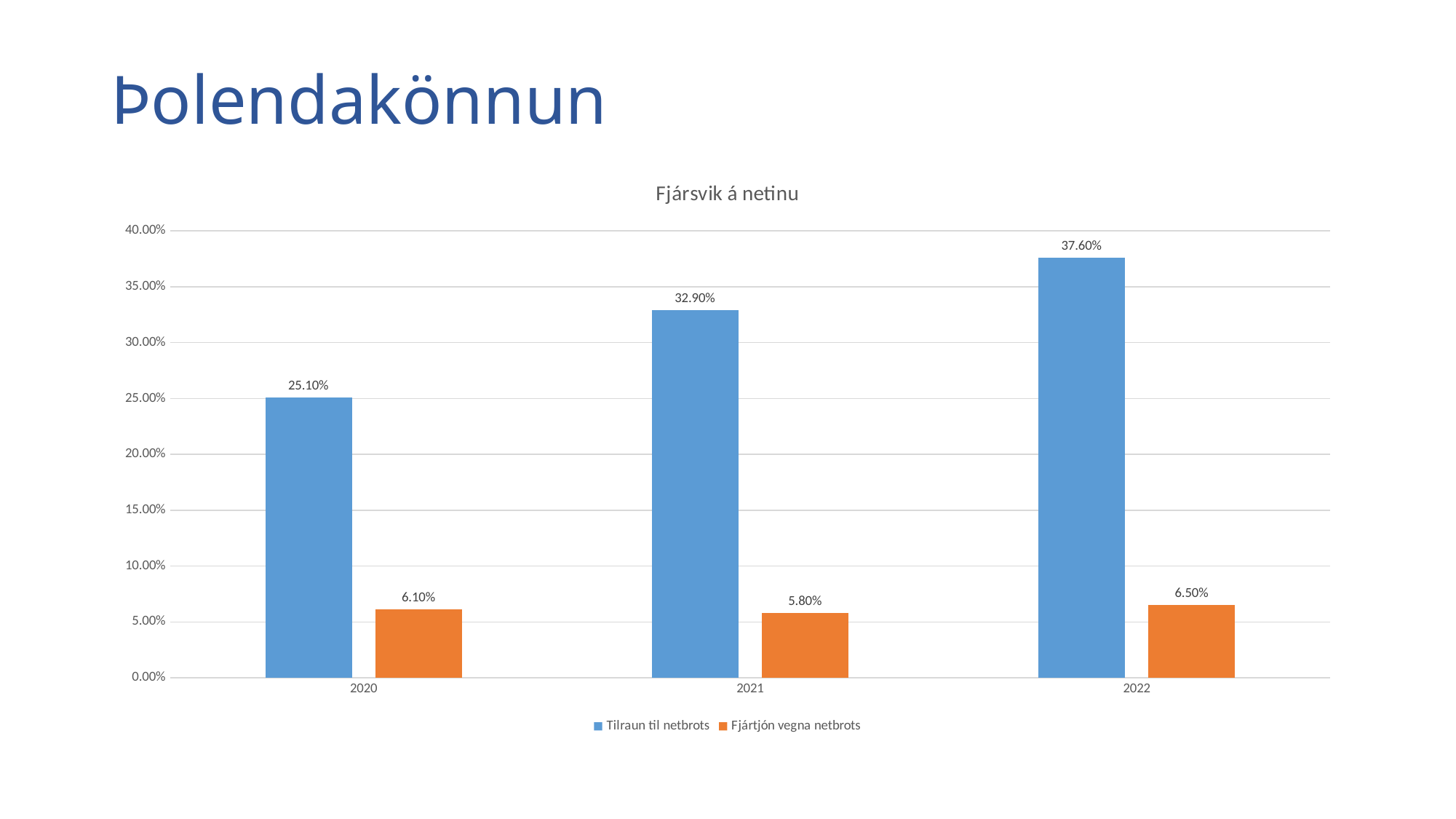
What is the value for Fjártjón vegna netbrots in 2020? 6.10% What is the value for Tilraun til netbrots in 2021? 32.90% What is the value for Tilraun til netbrots in 2022? 37.60% Does Tilraun til netbrots rise or fall from 2020 to 2022? rise Which is larger: Fjártjón vegna netbrots in 2022 or in 2020? 2022 What is the difference between Tilraun til netbrots in 2022 and in 2020? 12.50% How many years are shown on the x axis? 3 In which year is Fjártjón vegna netbrots lowest? 2021 In which year is Tilraun til netbrots highest? 2022 What kind of chart is shown? bar chart Is the value for Tilraun til netbrots in 2020 greater or less than 20.00%? greater How many series does the legend list? 2